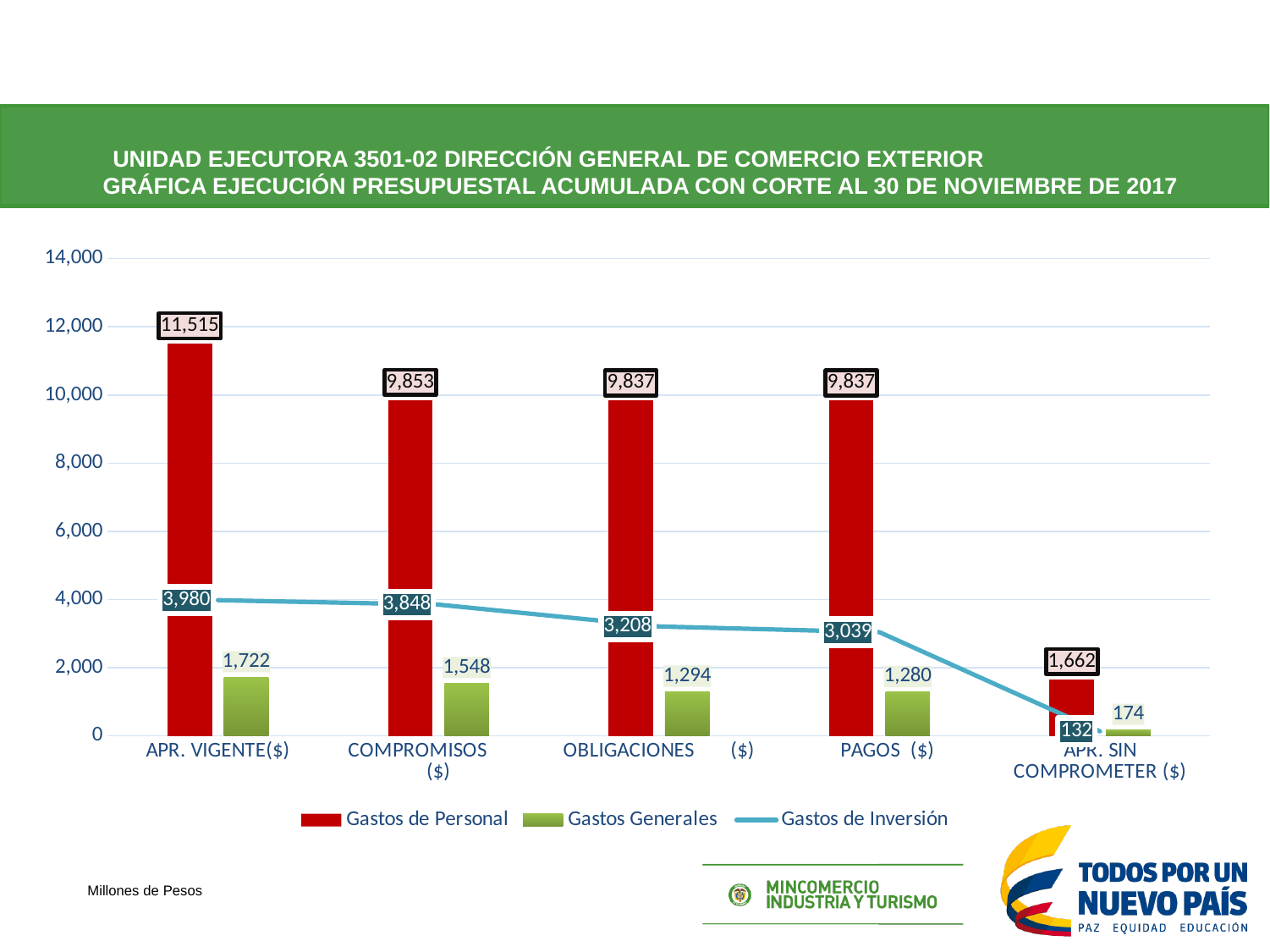
What is the difference between Gastos de Personal for APR. VIGENTE($) and for COMPROMISOS ($)? 1,662 What is the value of Gastos de Inversión for APR. SIN COMPROMETER ($)? 132 What is the value of Gastos Generales for COMPROMISOS ($)? 1,548 Which category has the highest value for Gastos de Personal? APR. VIGENTE($) How many categories are shown on the x axis? 5 Does the Gastos de Inversión line rise or fall from APR. VIGENTE($) to APR. SIN COMPROMETER ($)? fall Which is larger: Gastos de Inversión for COMPROMISOS ($) or Gastos de Inversión for PAGOS ($)? COMPROMISOS ($) Which series is shown as a line rather than bars? Gastos de Inversión What is the value of Gastos de Personal for APR. VIGENTE($)? 11,515 How many series does the legend list? 3 What is the value of Gastos de Inversión for OBLIGACIONES ($)? 3,208 Which category has the lowest value for Gastos Generales? APR. SIN COMPROMETER ($)